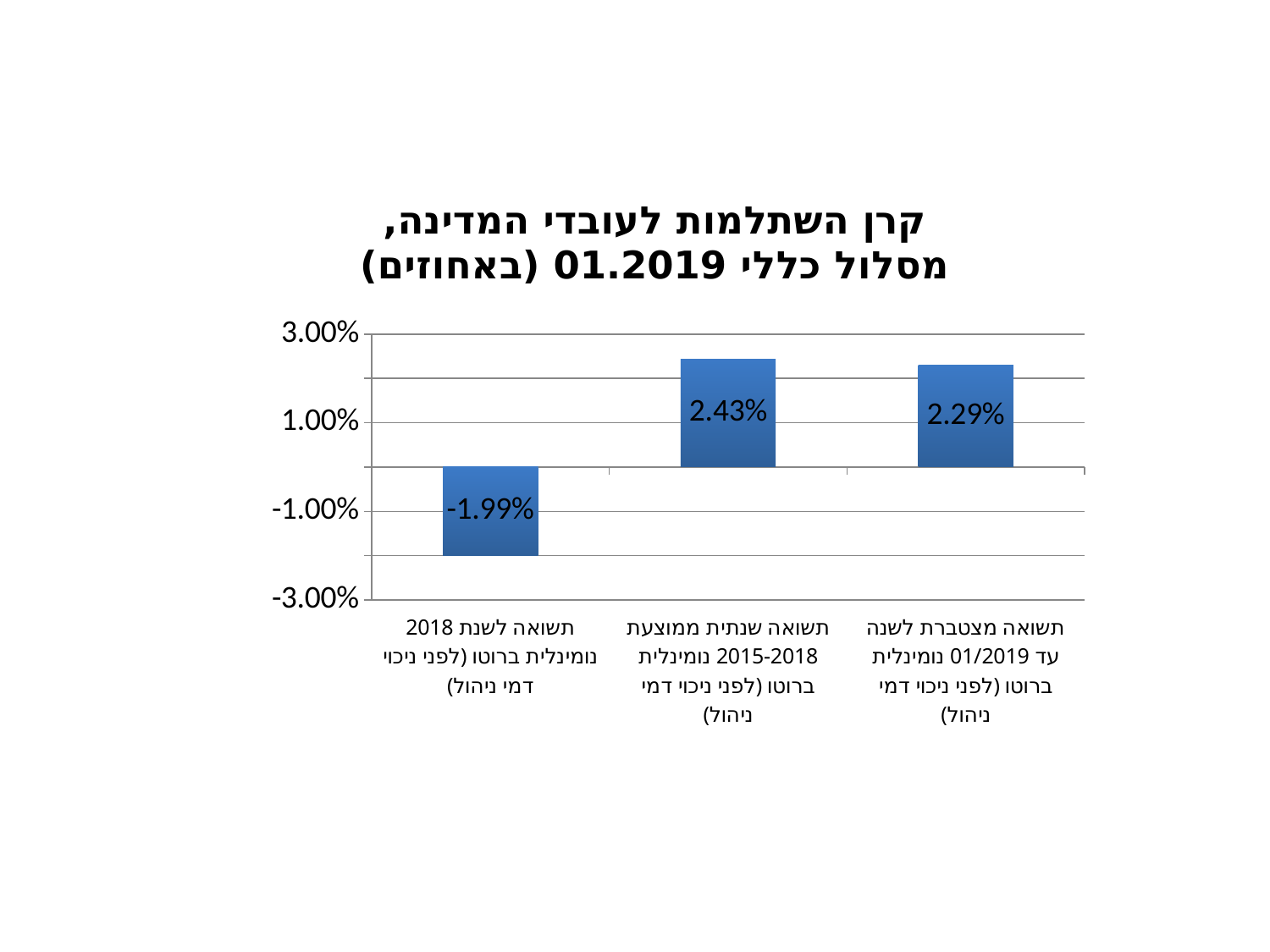
What type of chart is shown on the slide? Bar chart Which is larger: the average annual return 2015-2018 or the cumulative return to 01/2019? The average annual return 2015-2018 (2.43%) What is the value of the bar for 'תשואה מצטברת לשנה עד 01/2019 נומינלית ברוטו' (cumulative return for the year to 01/2019)? 2.29% Which category has the lowest value in the chart? תשואה לשנת 2018 נומינלית ברוטו (לפני ניכוי דמי ניהול) What is the title of the chart? קרן השתלמות לעובדי המדינה, מסלול כללי 01.2019 (באחוזים) What is the value of the bar for 'תשואה שנתית ממוצעת 2015-2018 נומינלית ברוטו' (average annual nominal gross return 2015-2018)? 2.43% Which category has the highest value in the chart? תשואה שנתית ממוצעת 2015-2018 נומינלית ברוטו (לפני ניכוי דמי ניהול) What is the difference between the average annual return 2015-2018 (2.43%) and the 2018 return (-1.99%)? 4.42% What is the difference between the average annual return 2015-2018 (2.43%) and the cumulative return to 01/2019 (2.29%)? 0.14% How many bars are shown in the chart? 3 Is the value for the 2018 return greater or less than 0%? less What is the value of the bar for 'תשואה לשנת 2018 נומינלית ברוטו (לפני ניכוי דמי ניהול)' (nominal gross return for 2018)? -1.99%